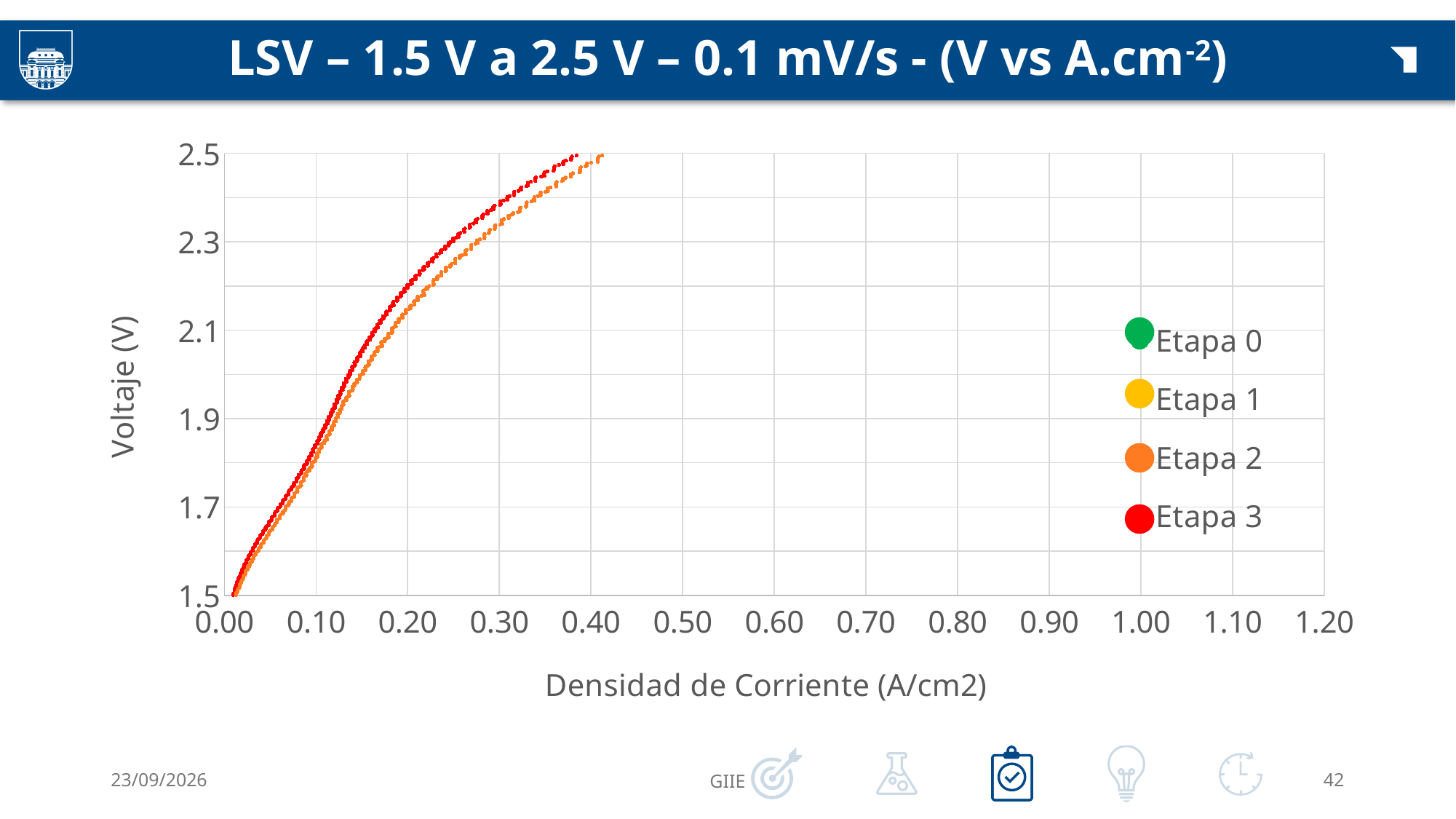
Is the maximum current density reached by Etapa 2 greater or less than 0.30 A/cm2? greater What is the label of the y axis? Voltaje (V) Does the voltage rise or fall as current density increases along the x axis? rise At 2.5 V, which series reaches the higher current density, Etapa 2 or Etapa 3? Etapa 2 What kind of chart is shown on the slide? scatter chart Is the current density of Etapa 3 at 2.1 V greater or less than 0.30 A/cm2? less Is the maximum current density reached by Etapa 2 greater or less than 0.50 A/cm2? less What is the title of the chart? LSV – 1.5 V a 2.5 V – 0.1 mV/s - (V vs A.cm-2) At 2.3 V, which series has the higher current density, Etapa 2 or Etapa 3? Etapa 2 How many series does the legend list? 4 Which series reaches the highest current density on the chart? Etapa 2